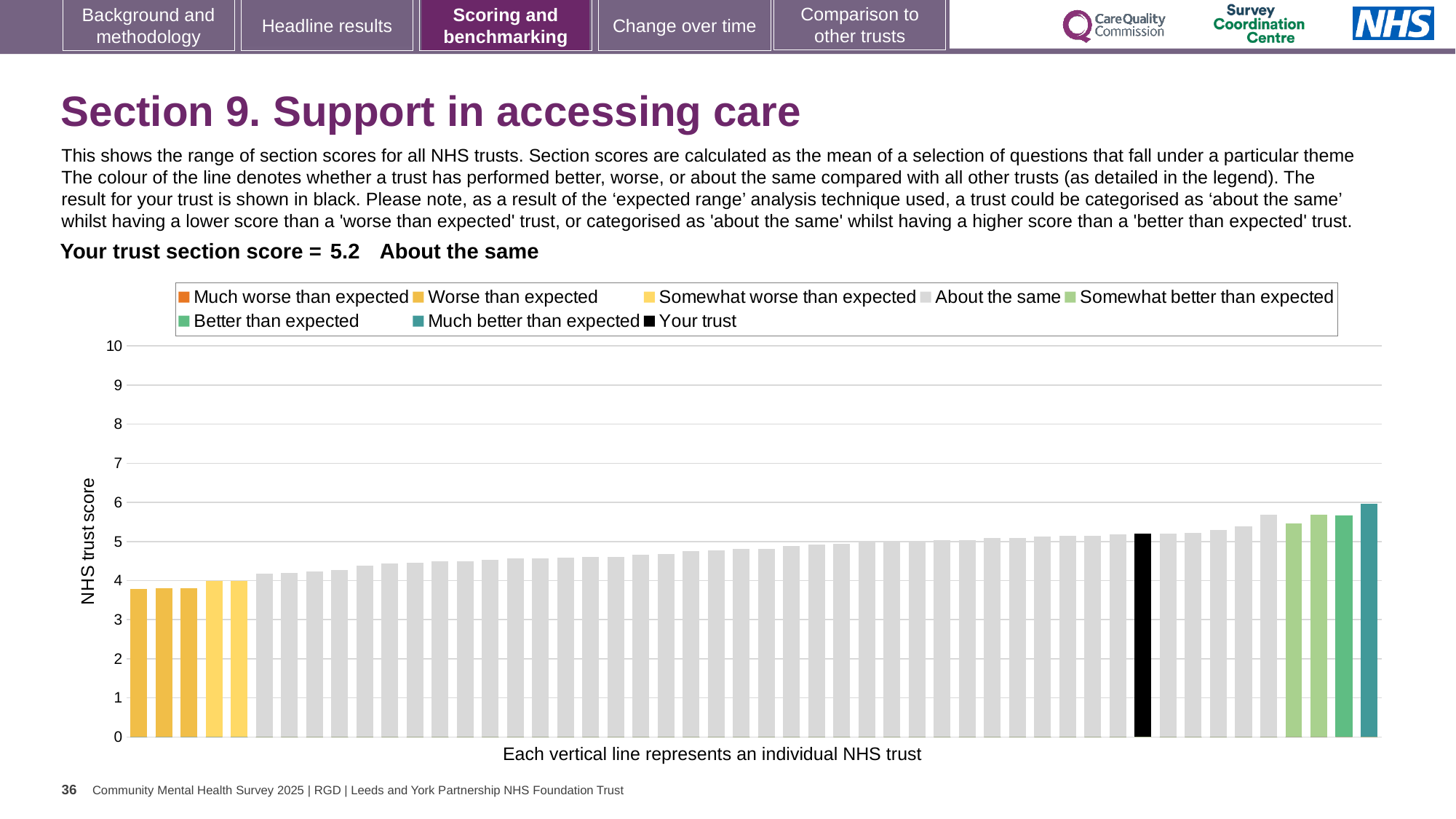
Is the value of the lowest bar on the chart greater or less than 4? less What colour is the bar representing your trust? black Is the value of the tallest bar on the chart greater or less than 5? greater What is the section score for your trust shown on the slide? 5.2 How many series does the legend list? 8 Which legend category do the lowest bars on the chart belong to? Worse than expected How many bars are coloured as 'Much better than expected'? 1 Do the bar values rise or fall from left to right along the x axis? rise Is the value for your trust (the black bar) greater or less than 5? greater What kind of chart is shown on the slide? bar chart What is the label on the y axis of the chart? NHS trust score Which legend category does the tallest bar on the chart belong to? Much better than expected